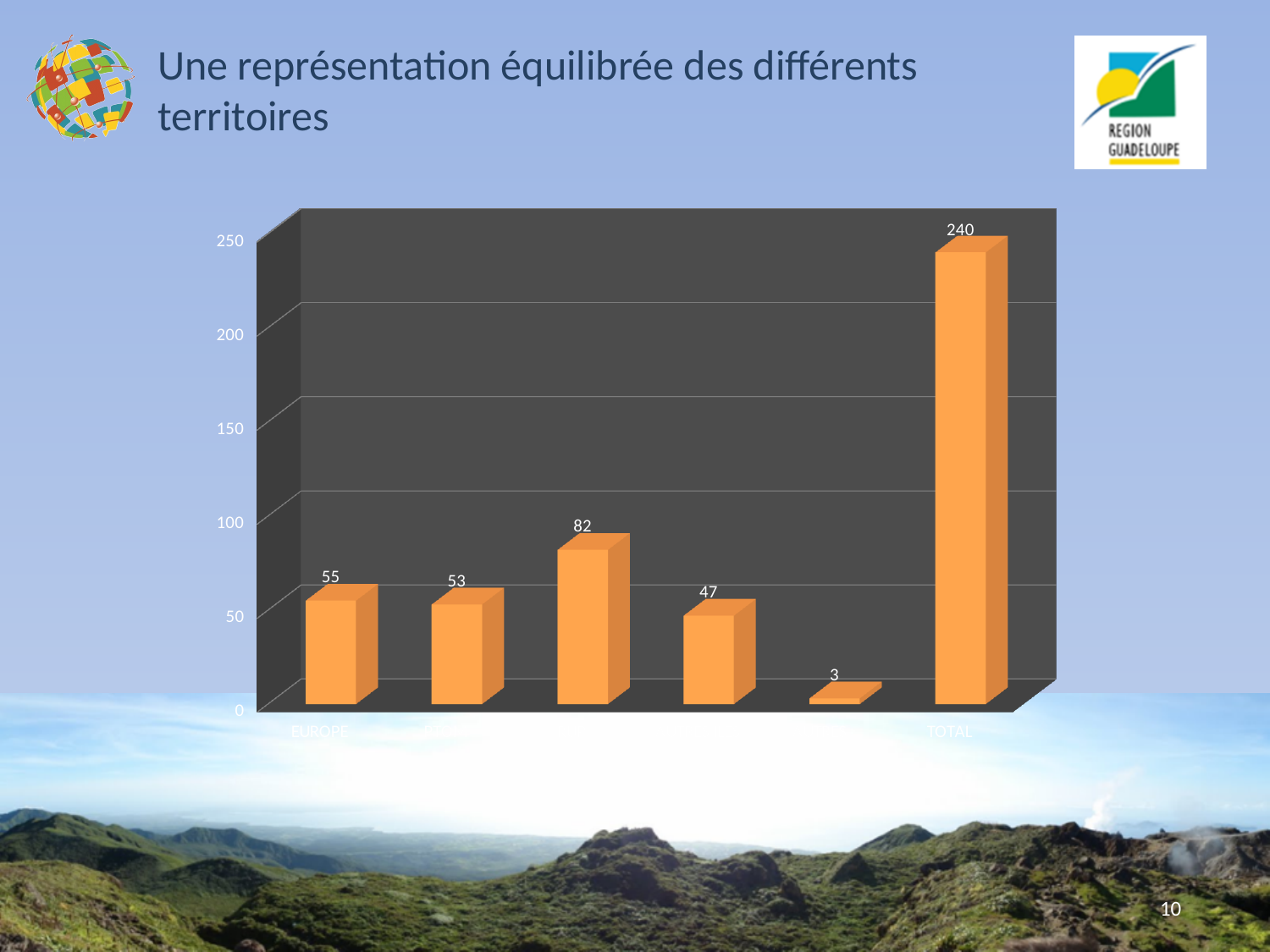
What is the value of the fifth bar from the left? 3 How many bars are plotted in the chart? 6 What is the value of the TOTAL bar? 240 What is the value of the third bar from the left? 82 Which is larger, the EUROPE bar or the second bar from the left? EUROPE What is the difference between the TOTAL bar and the EUROPE bar? 185 What is the value of the EUROPE bar? 55 What is the lowest value shown on any bar? 3 What kind of chart is shown on the slide? bar chart Which bar has the highest value? TOTAL What is the title of the slide containing the chart? Une représentation équilibrée des différents territoires Is the value of the third bar from the left greater or less than 100? less